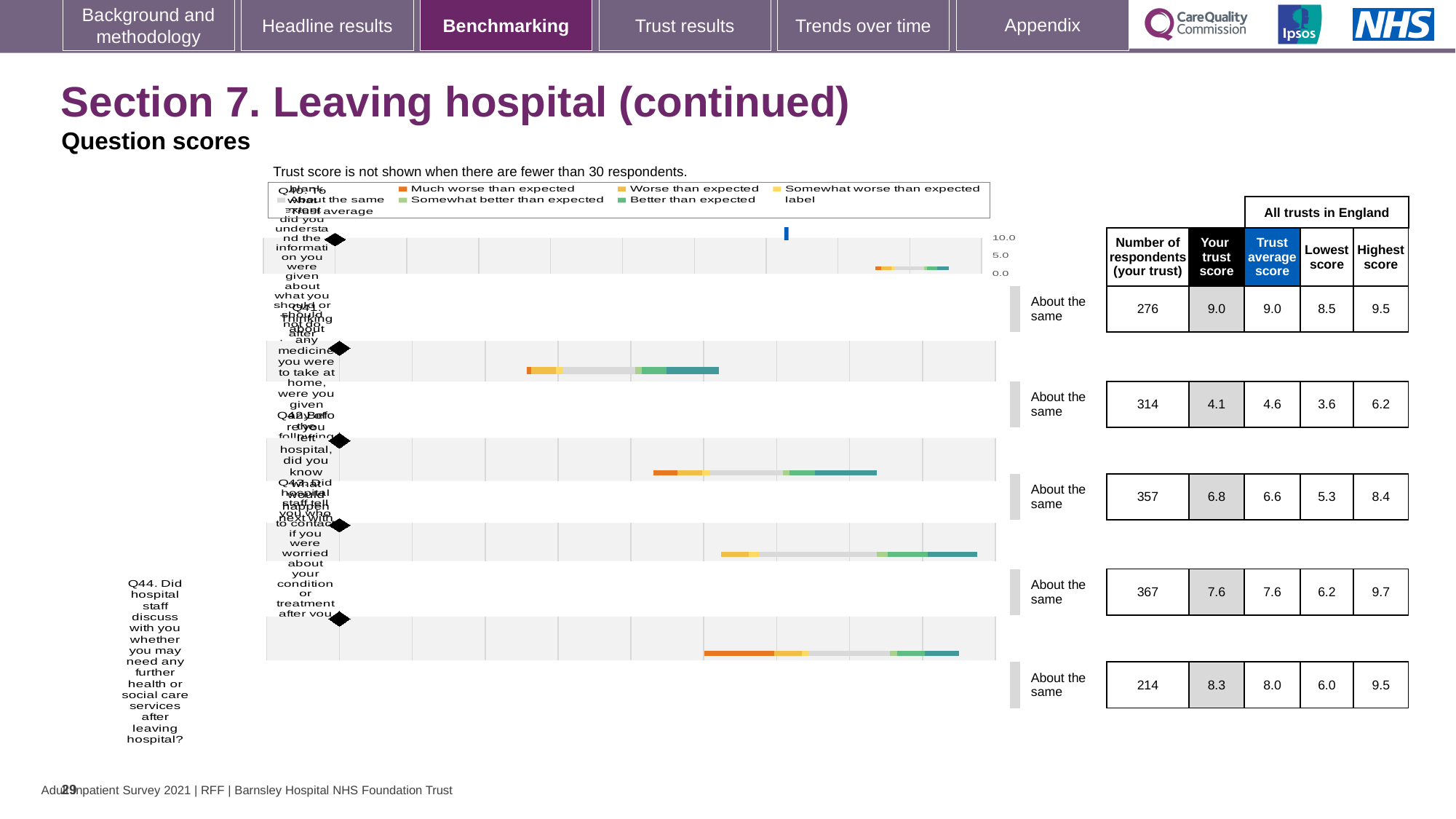
How many question rows are shown in the benchmarking chart and table on this slide? 5 Which question row has the lowest 'Your trust score' in the table? The second row (4.1) How many question rows are labelled 'About the same' on this slide? 5 Which question row has the highest 'Your trust score' in the table? The first row (9.0) In the table, how many respondents are shown for Q44 (Did hospital staff discuss with you whether you may need any further health or social care services after leaving hospital?)? 214 In the second question row, which is larger: 'Your trust score' (4.1) or 'Trust average score' (4.6)? Trust average score What is the 'Trust average score' for Q44, the last question row on the slide? 8.0 How many respondents are shown for the first question row in the table? 276 What is the 'Highest score' across all trusts in England for Q44, the last question row? 9.5 What is the 'Your trust score' for Q44, the last question row on the slide? 8.3 For Q44, the last question row, what is the difference between 'Your trust score' and 'Trust average score'? 0.3 What is the 'Lowest score' across all trusts in England for Q44, the last question row? 6.0